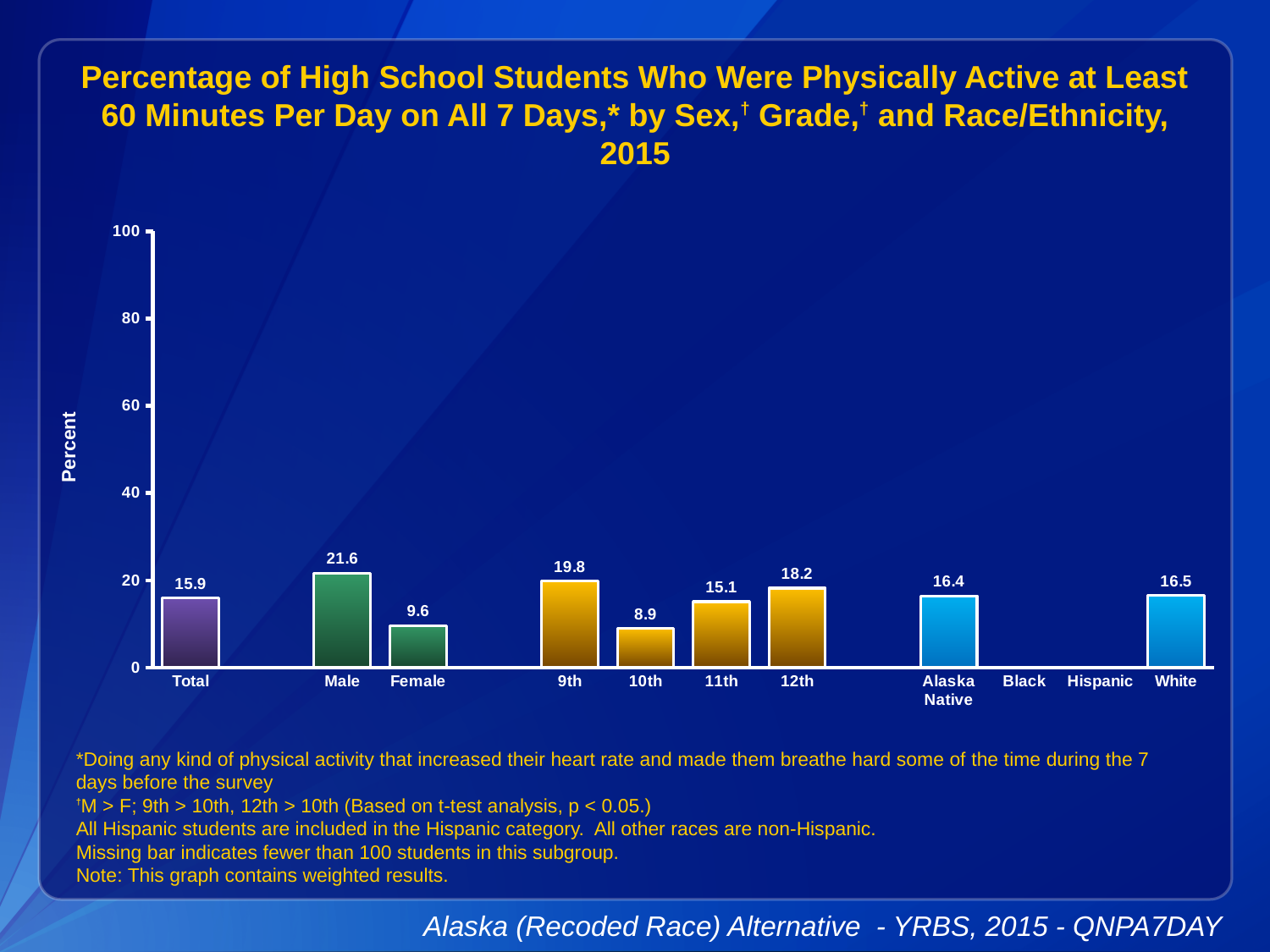
Which category has the lowest plotted value? 10th What is the value for Total? 15.9 Which race/ethnicity categories have no bar shown? Black and Hispanic Is the value for Female greater or less than 20? less What kind of chart is shown? bar chart What is the difference between the 9th and 10th grade values? 10.9 What is the value for Male? 21.6 Which category has the highest value? Male Which is larger, the value for 11th grade or 12th grade? 12th What is the difference between the Male and Female values? 12.0 What is the value for Alaska Native? 16.4 What is the value for 10th grade? 8.9